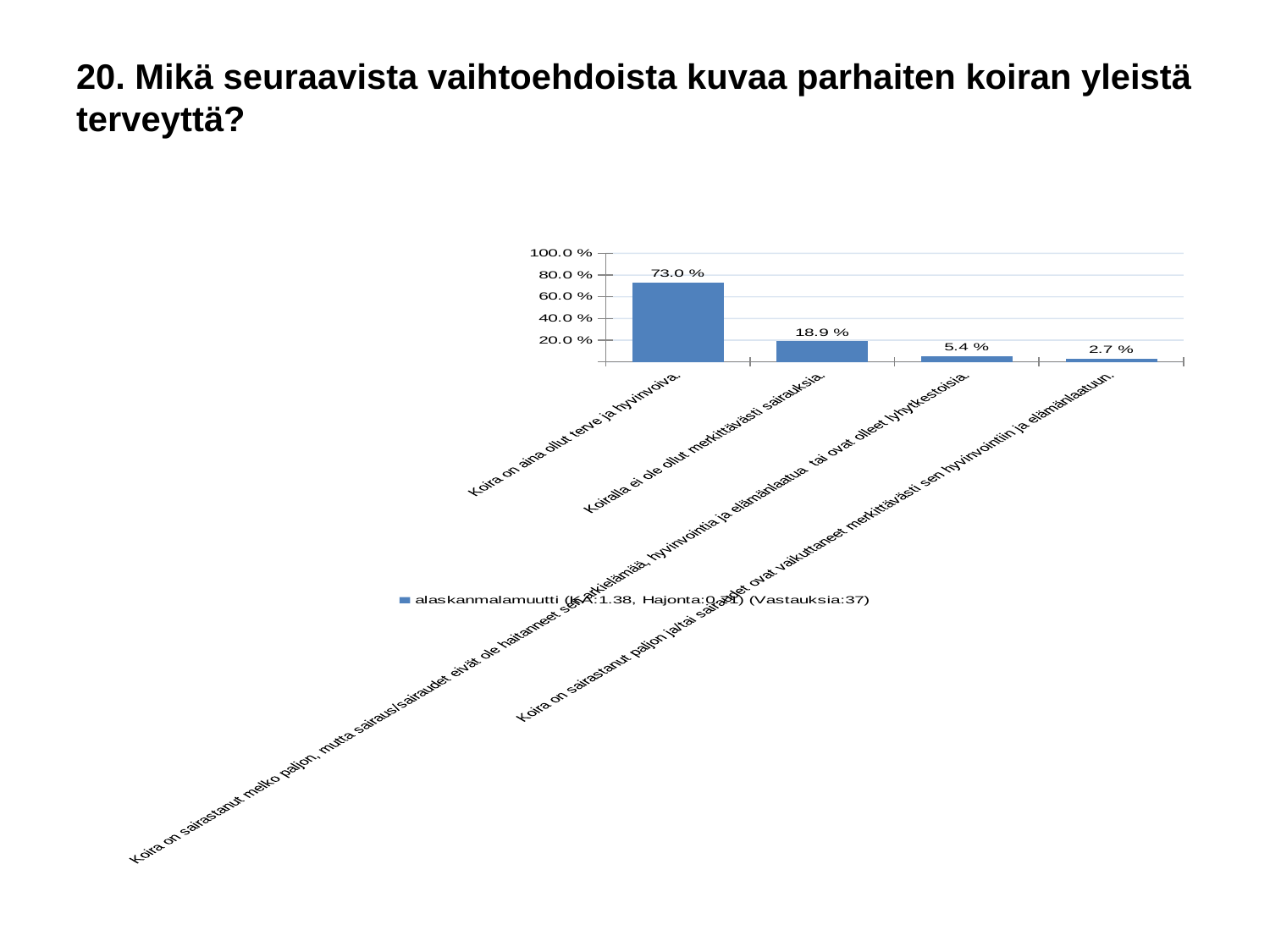
Which category has the lowest value? Koira on sairastanut paljon ja/tai sairaudet ovat vaikuttaneet merkittävästi sen hyvinvointiin ja elämänlaatuun. What is the value for "Koiralla ei ole ollut merkittävästi sairauksia."? 18.9 % What is the difference between the values for "Koira on aina ollut terve ja hyvinvoiva." and "Koiralla ei ole ollut merkittävästi sairauksia."? 54.1 % What is the value for "Koira on aina ollut terve ja hyvinvoiva."? 73.0 % Which is larger: the value for "Koiralla ei ole ollut merkittävästi sairauksia." or the value of the third bar? Koiralla ei ole ollut merkittävästi sairauksia. Do the values rise or fall from left to right along the x axis? fall Is the value for "Koira on aina ollut terve ja hyvinvoiva." greater or less than 60.0 %? greater Which category has the highest value? Koira on aina ollut terve ja hyvinvoiva. What kind of chart is shown on the slide? bar chart What is the value for the category "Koira on sairastanut paljon ja/tai sairaudet ovat vaikuttaneet merkittävästi sen hyvinvointiin ja elämänlaatuun."? 2.7 % How many categories are shown in the chart? 4 What is the value of the third bar from the left? 5.4 %